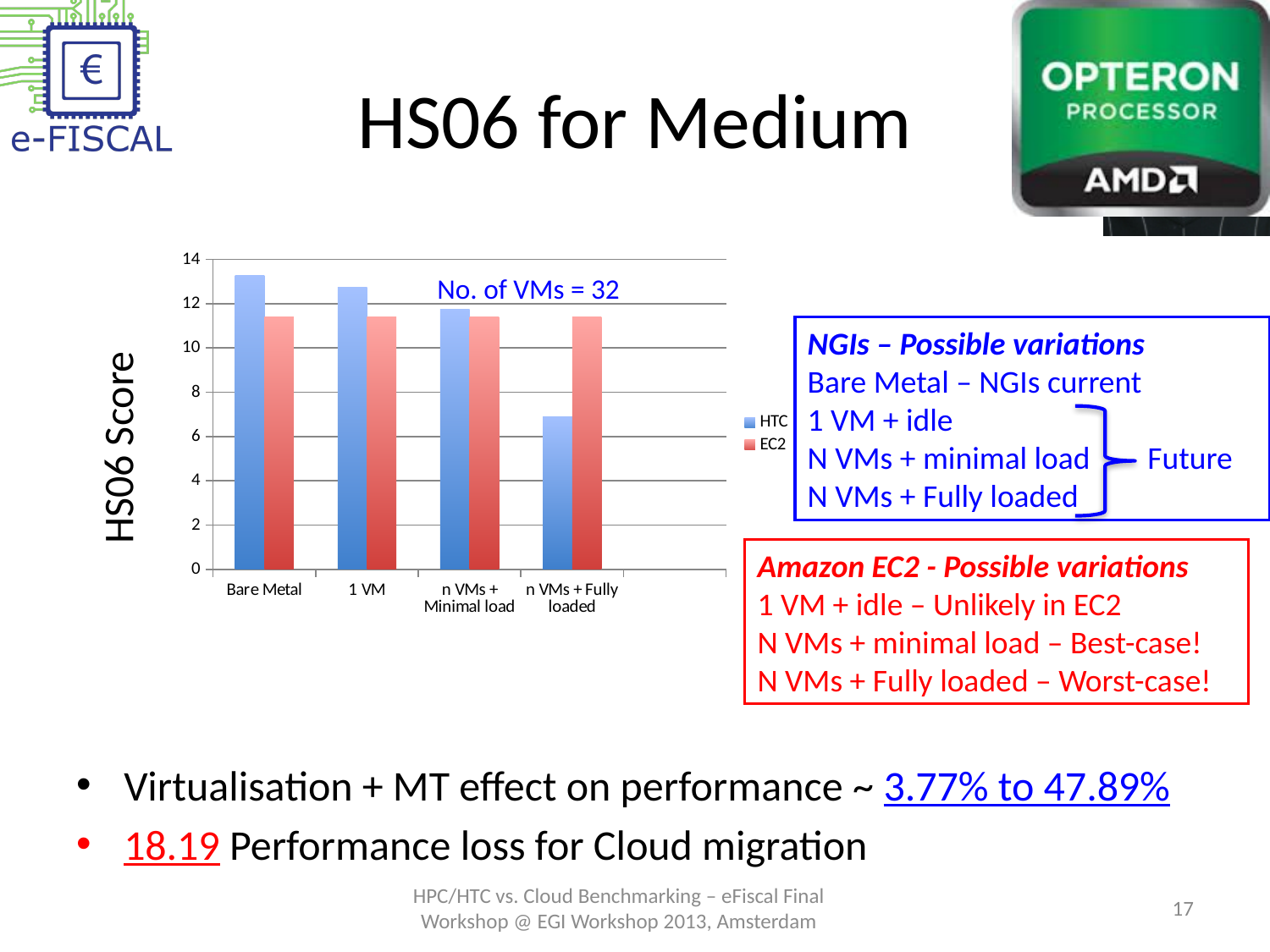
Is the EC2 value for 1 VM greater or less than 10? greater Which category has the highest HTC value? Bare Metal How many categories are shown on the x axis of the chart? 4 Is the HTC value for n VMs + Fully loaded greater or less than 8? less For Bare Metal, which series has the larger value, HTC or EC2? HTC Which category has the lowest HTC value? n VMs + Fully loaded Is the HTC value for Bare Metal greater or less than 12? greater How many series does the chart's legend list? 2 What is the title of the chart's y axis? HS06 Score What kind of chart is shown on the slide? bar chart Do the HTC values rise or fall moving from Bare Metal to n VMs + Fully loaded along the x axis? fall For n VMs + Fully loaded, which series has the larger value, HTC or EC2? EC2